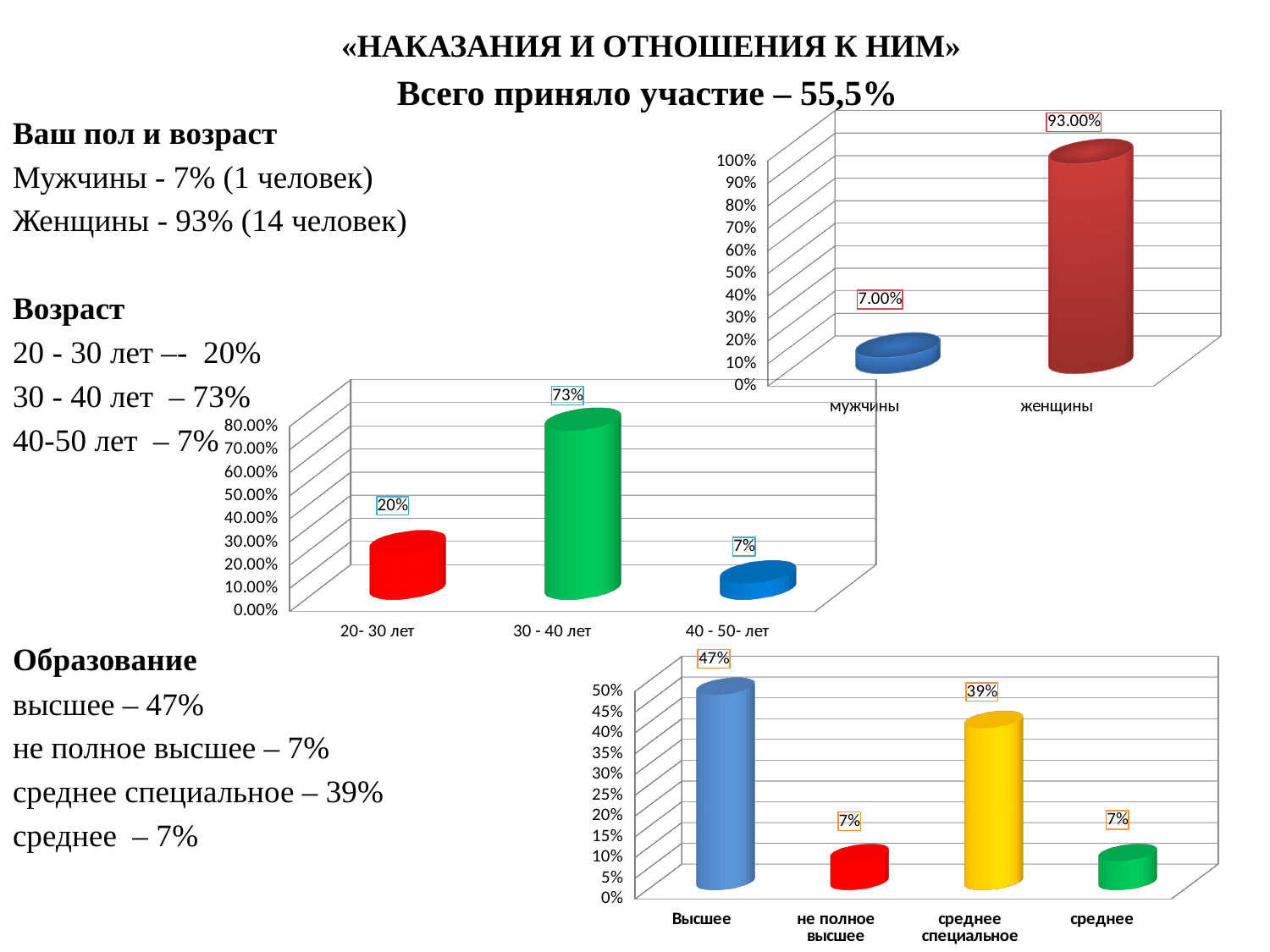
In the bottom-right chart, which is larger: the value for Высшее or the value for среднее специальное? Высшее In the middle chart, how many age categories are shown? 3 In the top-right chart, what is the value for мужчины? 7.00% In the bottom-right chart, how many categories are shown? 4 In the bottom-right chart, what is the value for среднее специальное? 39% In the bottom-right chart, what colour is the bar for среднее специальное? Yellow What kind of chart is the top-right chart? Bar chart In the middle chart, what is the value for 30 - 40 лет? 73% In the top-right chart, what is the value for женщины? 93.00% In the bottom-right chart, which category has the highest value? Высшее In the middle chart, which age category has the lowest value? 40 - 50- лет In the middle chart, what is the difference between the values for 30 - 40 лет and 20- 30 лет? 53%